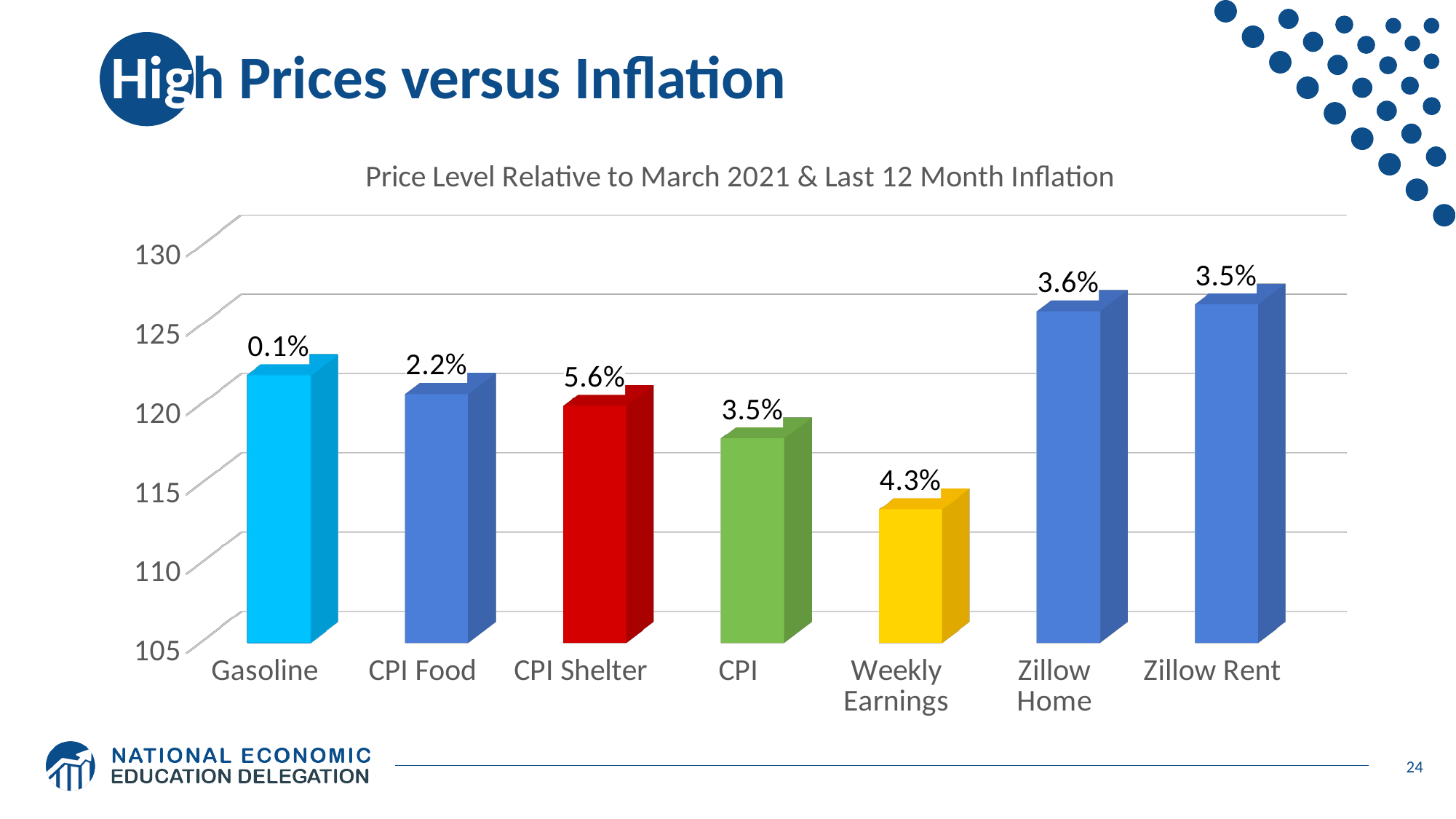
Which category has the lowest percentage label printed above its bar? Gasoline How many categories are shown on the x axis of the chart? 7 What percentage label is shown above the CPI Shelter bar? 5.6% What is the title of the chart? Price Level Relative to March 2021 & Last 12 Month Inflation Which category has the shortest bar in the chart? Weekly Earnings Is the bar for Weekly Earnings greater or less than 115 on the vertical axis? less What percentage label is shown above the Zillow Home bar? 3.6% Is the bar for Zillow Home greater or less than 125 on the vertical axis? greater What percentage label is shown above the Gasoline bar? 0.1% What is the difference between the percentage labels for CPI Shelter and Gasoline? 5.5 percentage points Which category has the highest percentage label printed above its bar? CPI Shelter What percentage label is shown above the Weekly Earnings bar? 4.3%